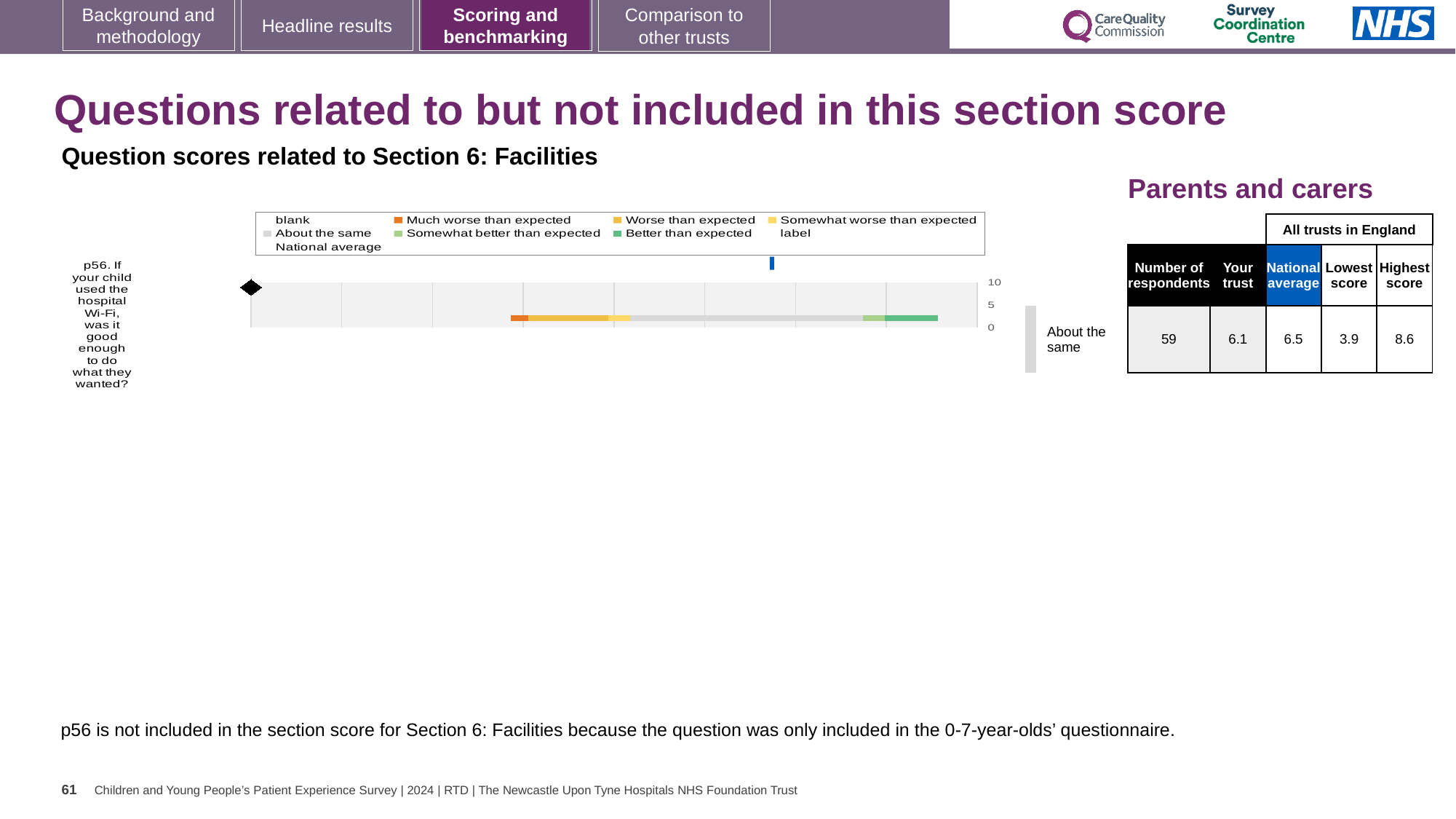
What is the lowest score among all trusts in England for question p56? 3.9 What kind of chart is shown on the slide? bar chart What is the national average score for question p56? 6.5 What is the highest score among all trusts in England for question p56? 8.6 How many respondents answered question p56? 59 What is the 'Your trust' score for question p56? 6.1 Which benchmarking category does question p56 fall into for this trust? About the same What is the difference between the highest and lowest trust scores for question p56? 4.7 Is the trust's score for question p56 greater or less than 5? greater How many survey questions are plotted in the chart? 1 Which is larger for question p56: the trust's score or the national average? national average What is the subtitle above the chart? Question scores related to Section 6: Facilities